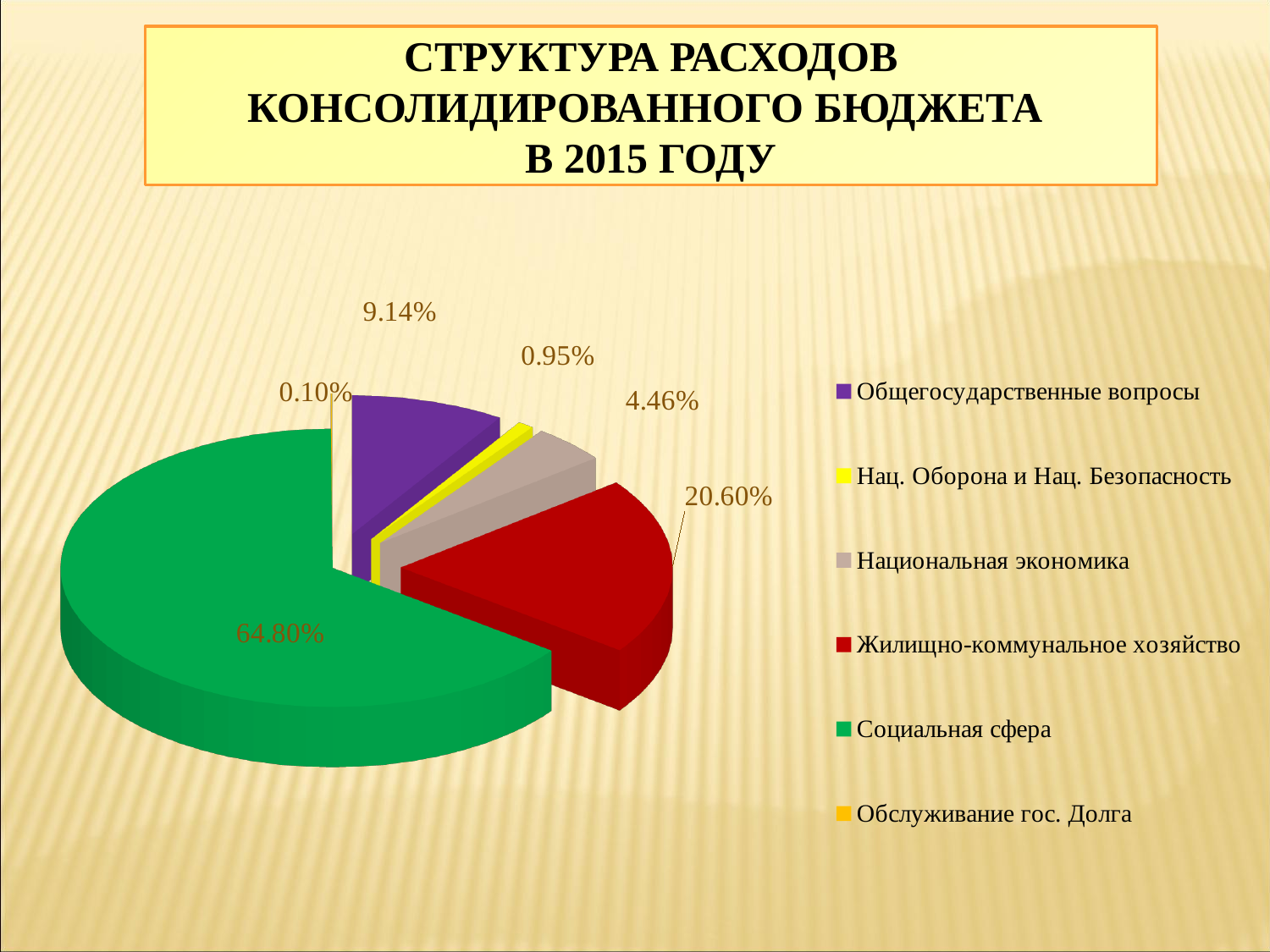
What is the share of Обслуживание гос. Долга? 0.10% What is the share of Национальная экономика? 4.46% What is the share of Общегосударственные вопросы? 9.14% What type of chart is shown on the slide? Pie chart Which category has the smallest share of the pie? Обслуживание гос. Долга What is the share of Жилищно-коммунальное хозяйство? 20.60% What is the share of Нац. Оборона и Нац. Безопасность? 0.95% What colour represents Жилищно-коммунальное хозяйство in the pie chart? Red How many categories does the legend list? 6 What is the share of Социальная сфера in the pie chart? 64.80% Which category has the largest share of the pie? Социальная сфера What is the difference in percentage points between Социальная сфера and Жилищно-коммунальное хозяйство? 44.20